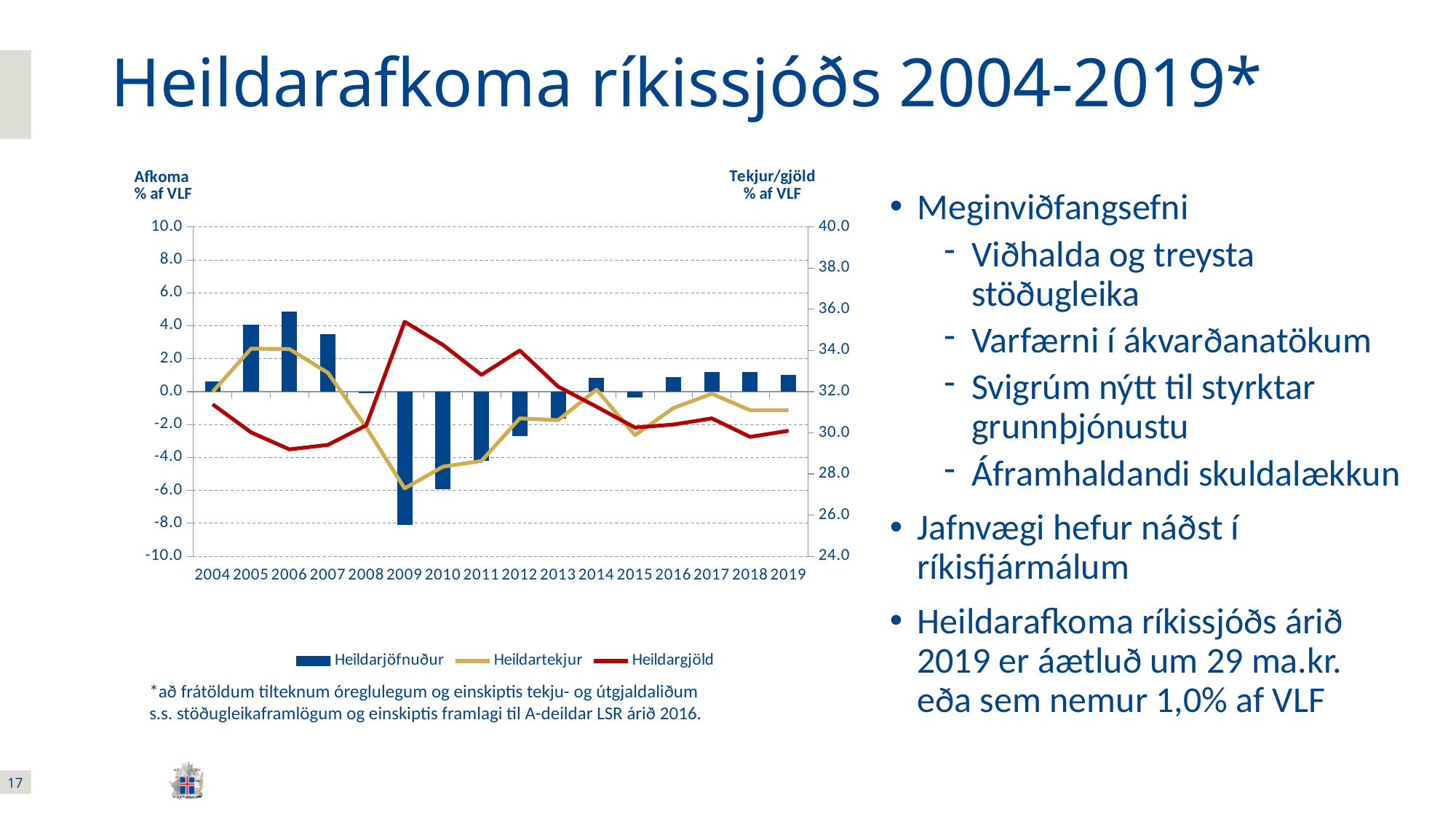
Which is larger, the Heildarjöfnuður bar for 2006 or for 2007? 2006 Is the Heildarjöfnuður value for 2006 greater or less than 4.0? greater Is the Heildartekjur value for 2009 greater or less than 28.0 on the right axis? less Do the Heildarjöfnuður bars rise or fall from 2009 to 2014? rise What kind of chart is shown on the slide? Combined bar and line chart How many years are shown on the x axis of the chart? 16 In which year is the Heildarjöfnuður bar highest? 2006 How many series does the chart legend list? 3 Which series is drawn as a red line in the chart? Heildargjöld In which year is the Heildarjöfnuður bar lowest? 2009 Is the Heildarjöfnuður value for 2009 greater or less than -6.0? less